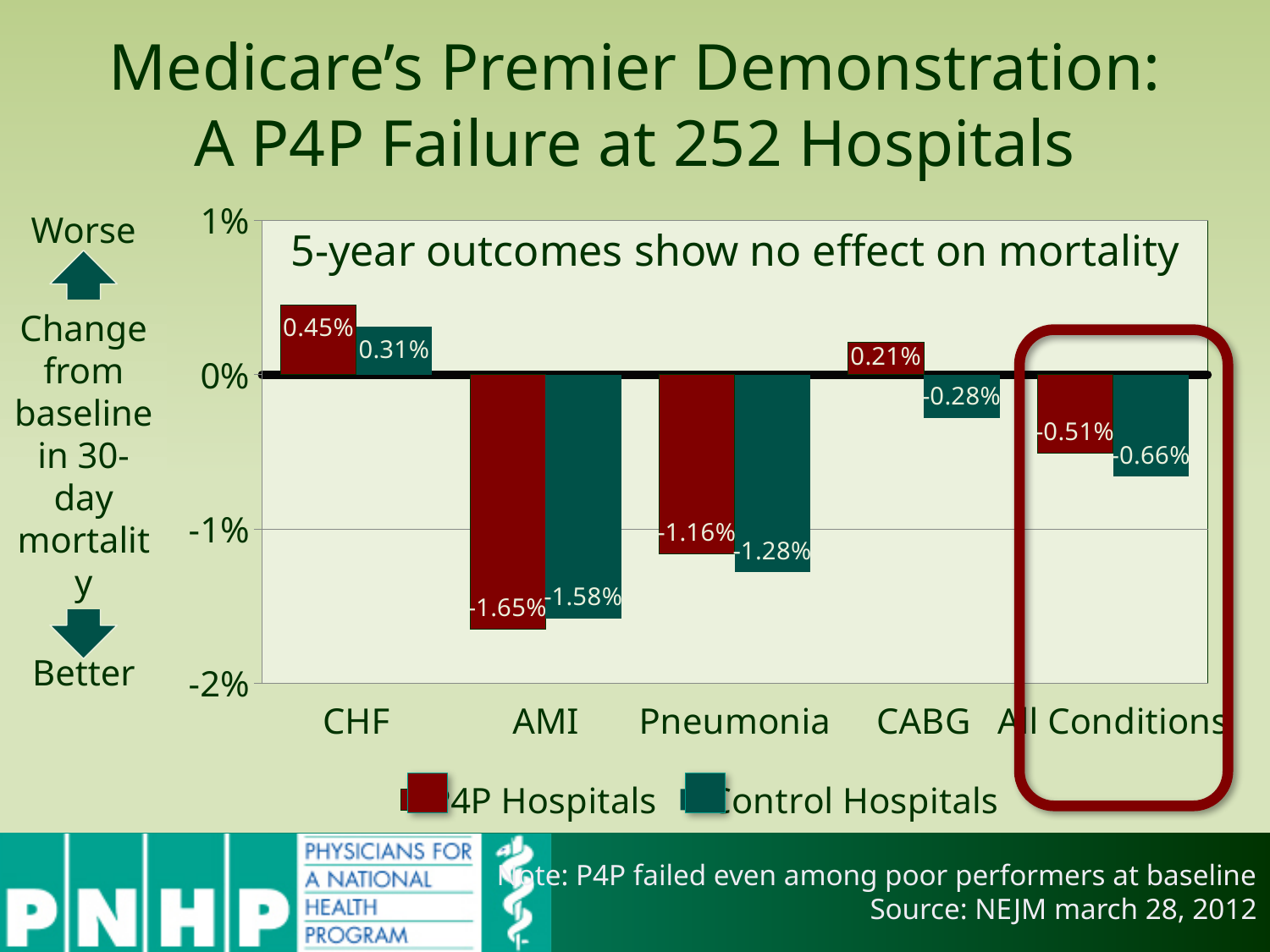
What is the difference between the P4P Hospitals and Control Hospitals values in the Pneumonia category? 0.12% What is the value for P4P Hospitals in the CHF category? 0.45% Which category has the highest value for Control Hospitals? CHF What is the value for P4P Hospitals in the All Conditions category? -0.51% In the CABG category, which is larger: the P4P Hospitals value or the Control Hospitals value? P4P Hospitals How many categories are shown on the x axis? 5 How many series does the legend list? 2 What is the value for Control Hospitals in the CABG category? -0.28% Is the value for Control Hospitals in the Pneumonia category greater or less than -1%? less Which category has the lowest value for P4P Hospitals? AMI What is the value for Control Hospitals in the AMI category? -1.58% What kind of chart is shown on the slide? Bar chart